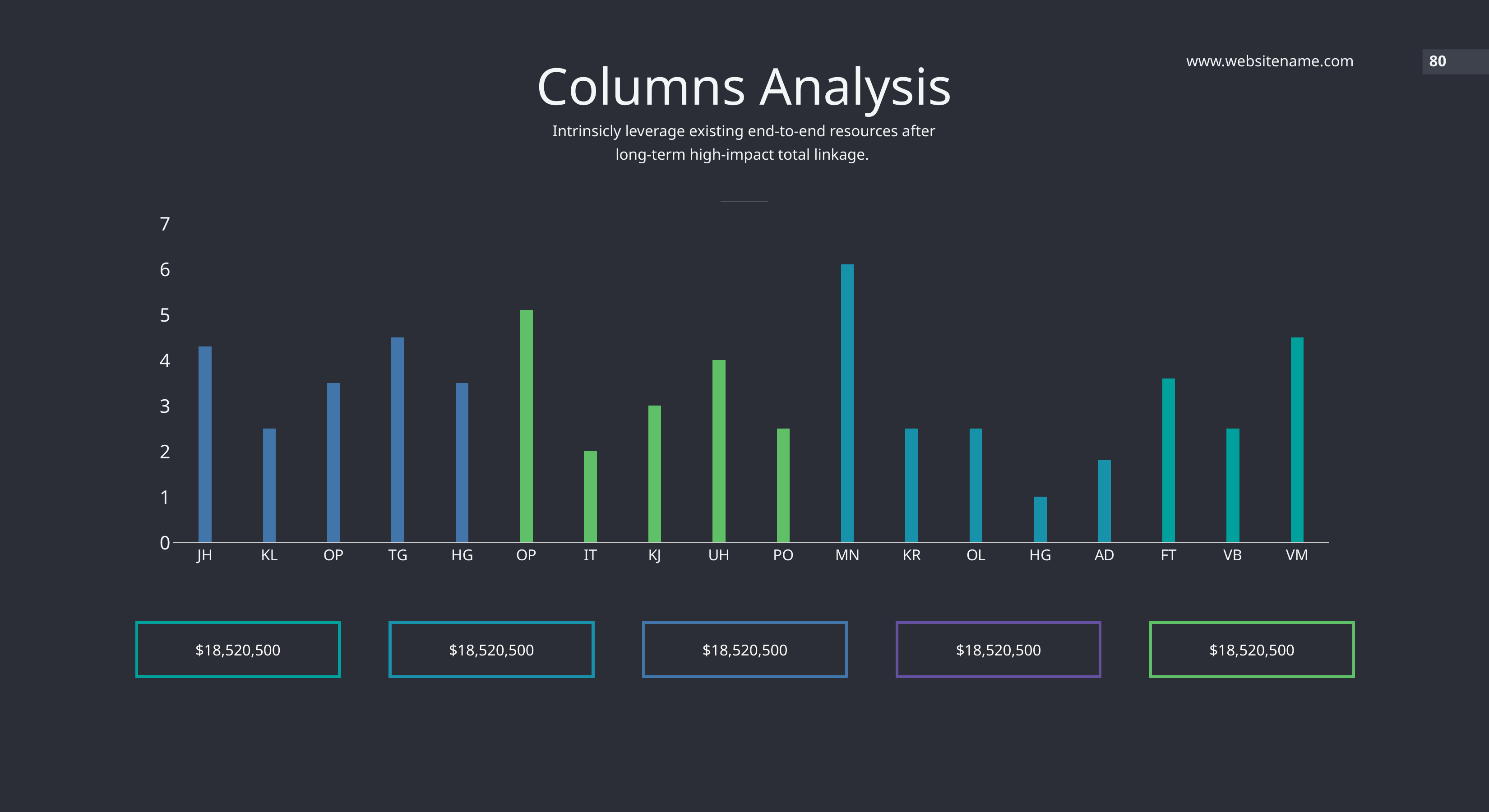
Which category has the highest bar in the chart? MN What is the title of the chart on the slide? Columns Analysis Which category has the lowest bar in the chart? HG Is the value for JH greater or less than 4? greater Is the value for VM greater or less than 4? greater Is the value for KL greater or less than 3? less Which is larger, the value for JH or the value for KL? JH How many bars (categories) are plotted in the chart? 18 Which is larger, the value for MN or the value for VM? MN What kind of chart is shown on the slide? bar chart